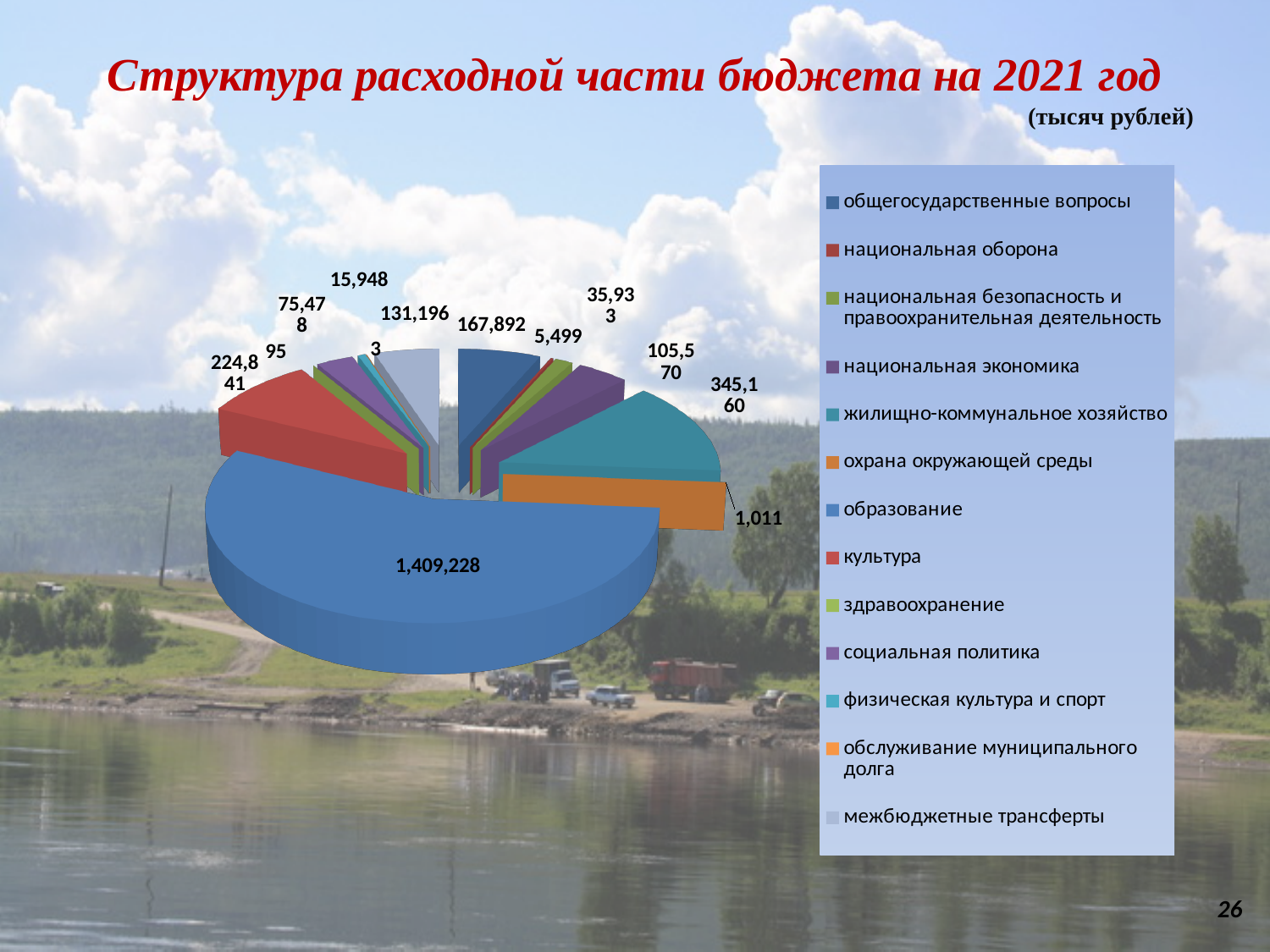
Which is larger, жилищно-коммунальное хозяйство or культура? жилищно-коммунальное хозяйство What is the value for культура? 224,841 What is the difference between образование and жилищно-коммунальное хозяйство? 1,064,068 What type of chart is shown on the slide? pie chart How many categories does the legend list? 13 What is the value for межбюджетные трансферты? 131,196 What is the value for жилищно-коммунальное хозяйство? 345,160 What is the value for образование? 1,409,228 What unit is stated under the chart title? тысяч рублей Which category has the largest slice of the pie? образование What is the value for национальная экономика? 105,570 What is the value for общегосударственные вопросы? 167,892